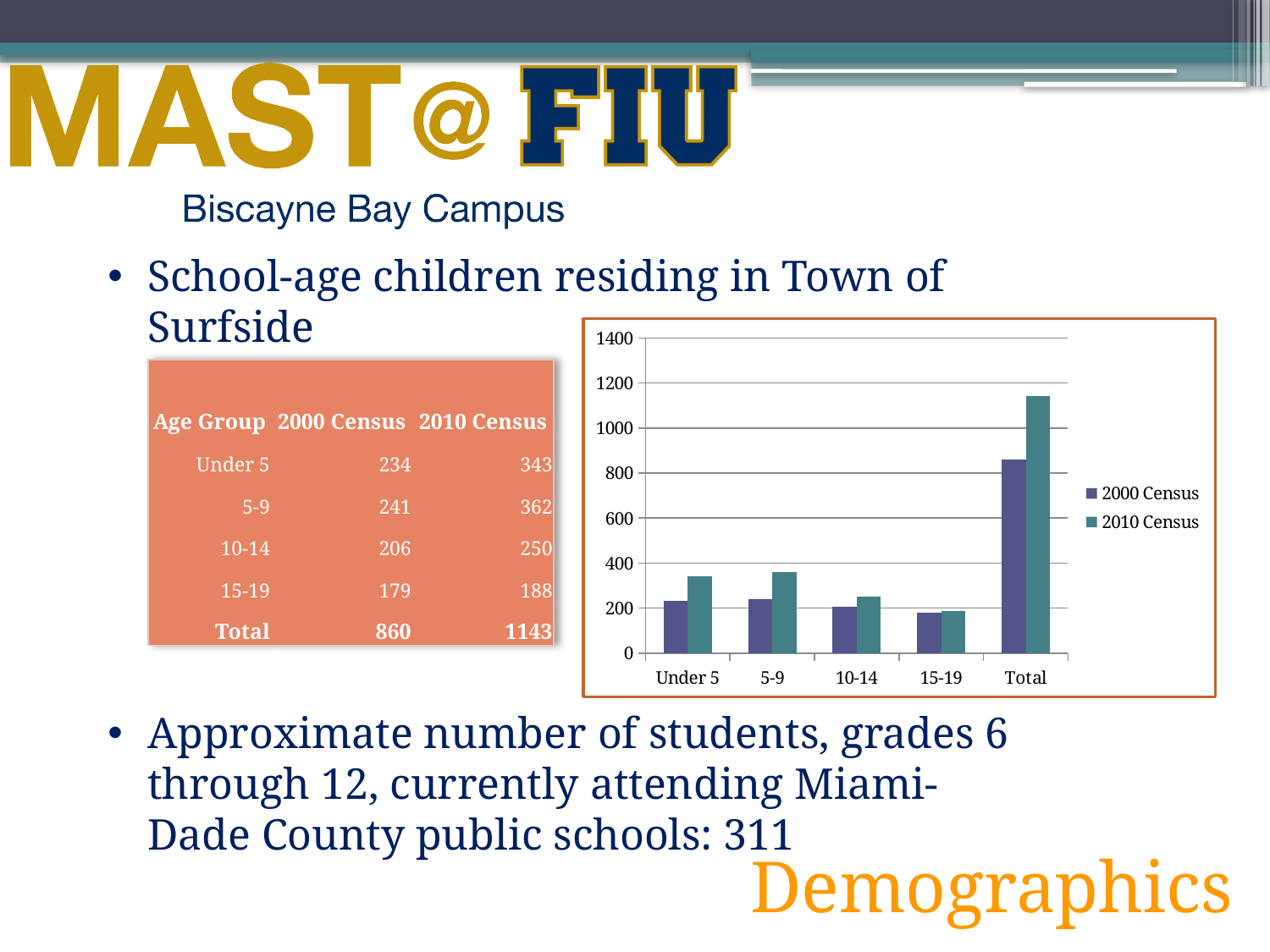
How many series does the chart legend list? 2 What is the 2010 Census value for the Under 5 age group? 343 What is the difference between the 2010 Census and 2000 Census totals? 283 Is the 2000 Census value for 15-19 greater or less than 200? less What kind of chart is shown on the slide? bar chart Is the 2010 Census value for 5-9 greater or less than 400? less How many age-group categories are shown on the x axis of the chart? 5 What are the two legend entries in the chart? 2000 Census and 2010 Census Which is larger for the 10-14 age group, the 2000 Census value or the 2010 Census value? 2010 Census Excluding Total, which age group has the lowest 2000 Census value in the chart? 15-19 Which category has the highest 2010 Census value in the chart? Total Is the 2010 Census value for Total greater or less than 1000? greater